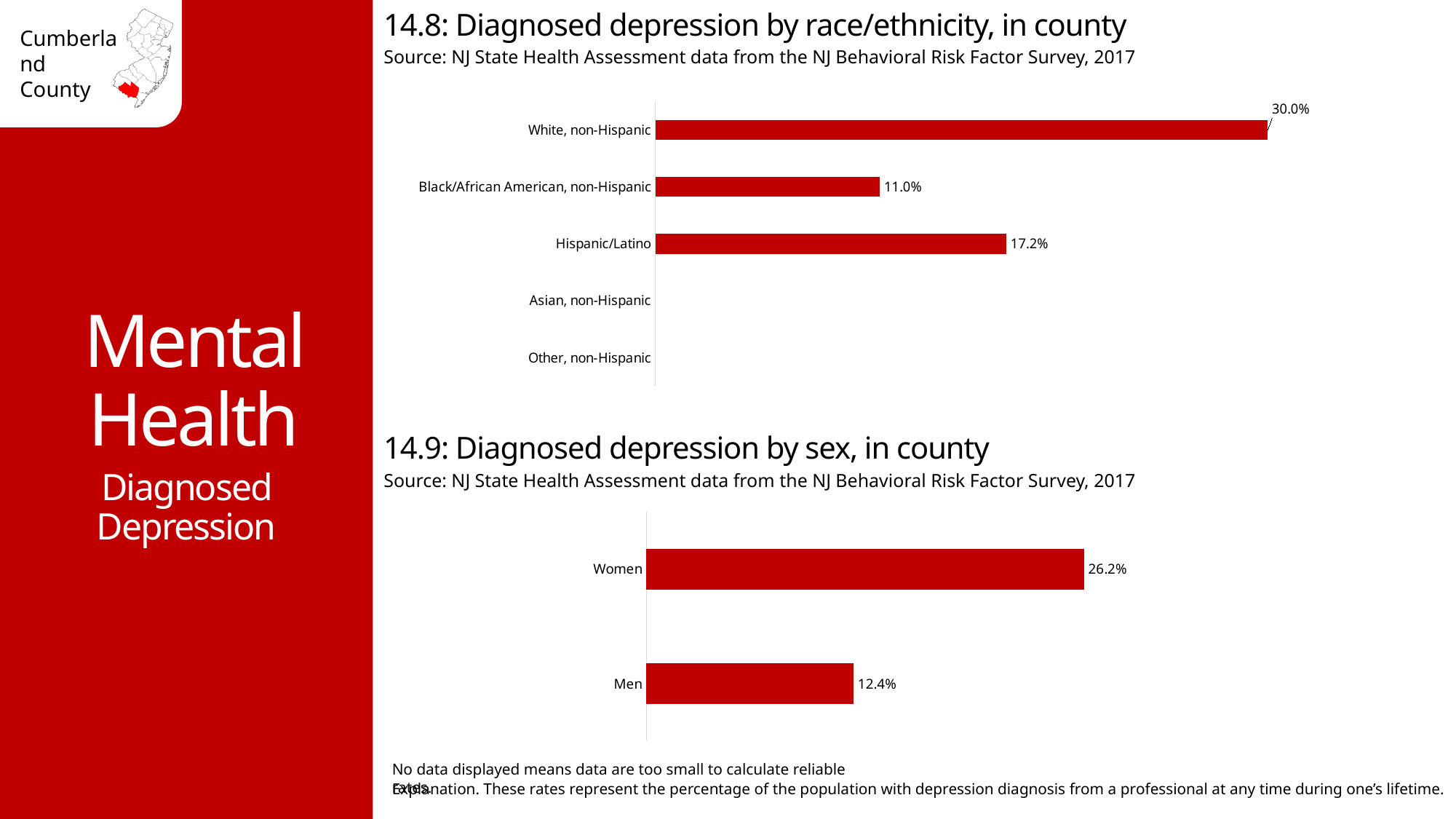
In the chart '14.9: Diagnosed depression by sex, in county', what is the value for Men? 12.4% In the chart '14.8: Diagnosed depression by race/ethnicity, in county', what is the value for Black/African American, non-Hispanic? 11.0% In the chart '14.8: Diagnosed depression by race/ethnicity, in county', how many categories are listed on the axis? 5 In the chart '14.8: Diagnosed depression by race/ethnicity, in county', which category has the highest value? White, non-Hispanic In the chart '14.8: Diagnosed depression by race/ethnicity, in county', what is the difference between the values for White, non-Hispanic and Hispanic/Latino? 12.8% What kind of chart is '14.9: Diagnosed depression by sex, in county'? Bar chart In the chart '14.9: Diagnosed depression by sex, in county', which is larger, the value for Women or the value for Men? Women In the chart '14.9: Diagnosed depression by sex, in county', what is the difference between the values for Women and Men? 13.8% In the chart '14.8: Diagnosed depression by race/ethnicity, in county', which categories have no bar displayed? Asian, non-Hispanic and Other, non-Hispanic In the chart '14.8: Diagnosed depression by race/ethnicity, in county', what is the value for White, non-Hispanic? 30.0% In the chart '14.9: Diagnosed depression by sex, in county', what is the value for Women? 26.2% In the chart '14.8: Diagnosed depression by race/ethnicity, in county', what is the value for Hispanic/Latino? 17.2%